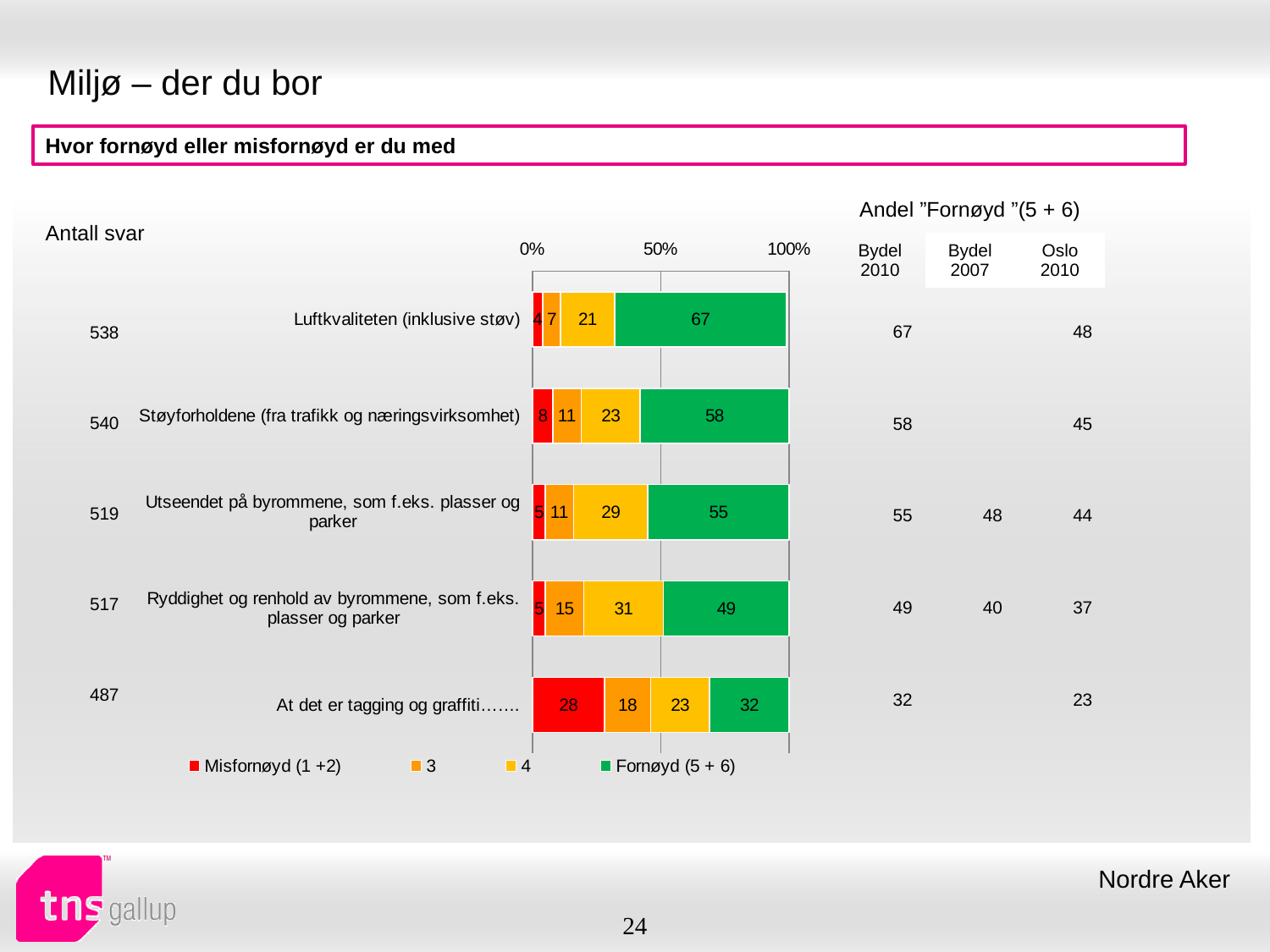
Which is larger: the "3" segment for "Ryddighet og renhold av byrommene" or the "3" segment for "Støyforholdene"? Ryddighet og renhold av byrommene What kind of chart is shown on the slide? Stacked bar chart How many categories are shown in the chart? 5 What is the total of the stacked bar for "At det er tagging og graffiti…"? 101 What is the value of the "Fornøyd (5 + 6)" segment for "Luftkvaliteten (inklusive støv)"? 67 Which category has the highest "Fornøyd (5 + 6)" value? Luftkvaliteten (inklusive støv) How many series does the legend list? 4 What is the value of the "Misfornøyd (1 +2)" segment for "At det er tagging og graffiti…"? 28 Which category has the lowest "Fornøyd (5 + 6)" value? At det er tagging og graffiti… What is the value of the "4" segment for "Ryddighet og renhold av byrommene, som f.eks. plasser og parker"? 31 What is the difference between the "Fornøyd (5 + 6)" values for "Luftkvaliteten (inklusive støv)" and "Støyforholdene (fra trafikk og næringsvirksomhet)"? 9 Which colour represents "Fornøyd (5 + 6)" in the legend? Green